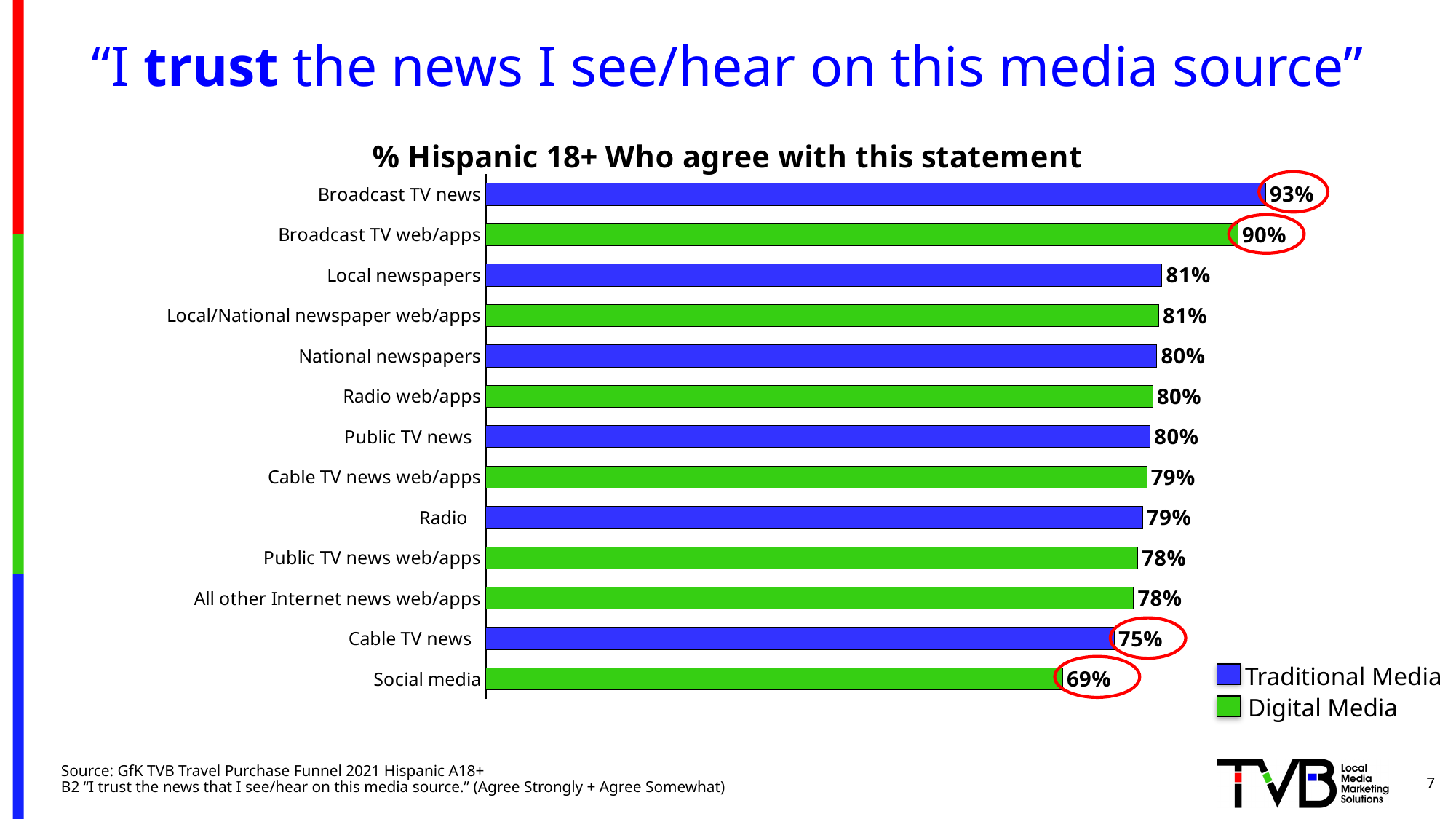
What is the difference in percentage points between Broadcast TV news and Broadcast TV web/apps? 3 Which media source has the highest percentage of agreement? Broadcast TV news How many series does the legend list? 2 How many media sources are shown in the chart? 13 What is the value shown for Social media? 69% What percentage of Hispanic 18+ agree they trust the news on Broadcast TV news? 93% What type of chart is shown on the slide? Bar chart Which has a higher value, Cable TV news or Cable TV news web/apps? Cable TV news web/apps Which media source has the lowest percentage of agreement? Social media What is the value shown for Broadcast TV web/apps? 90% What is the difference in percentage points between Broadcast TV news and Social media? 24 What is the value shown for Cable TV news? 75%